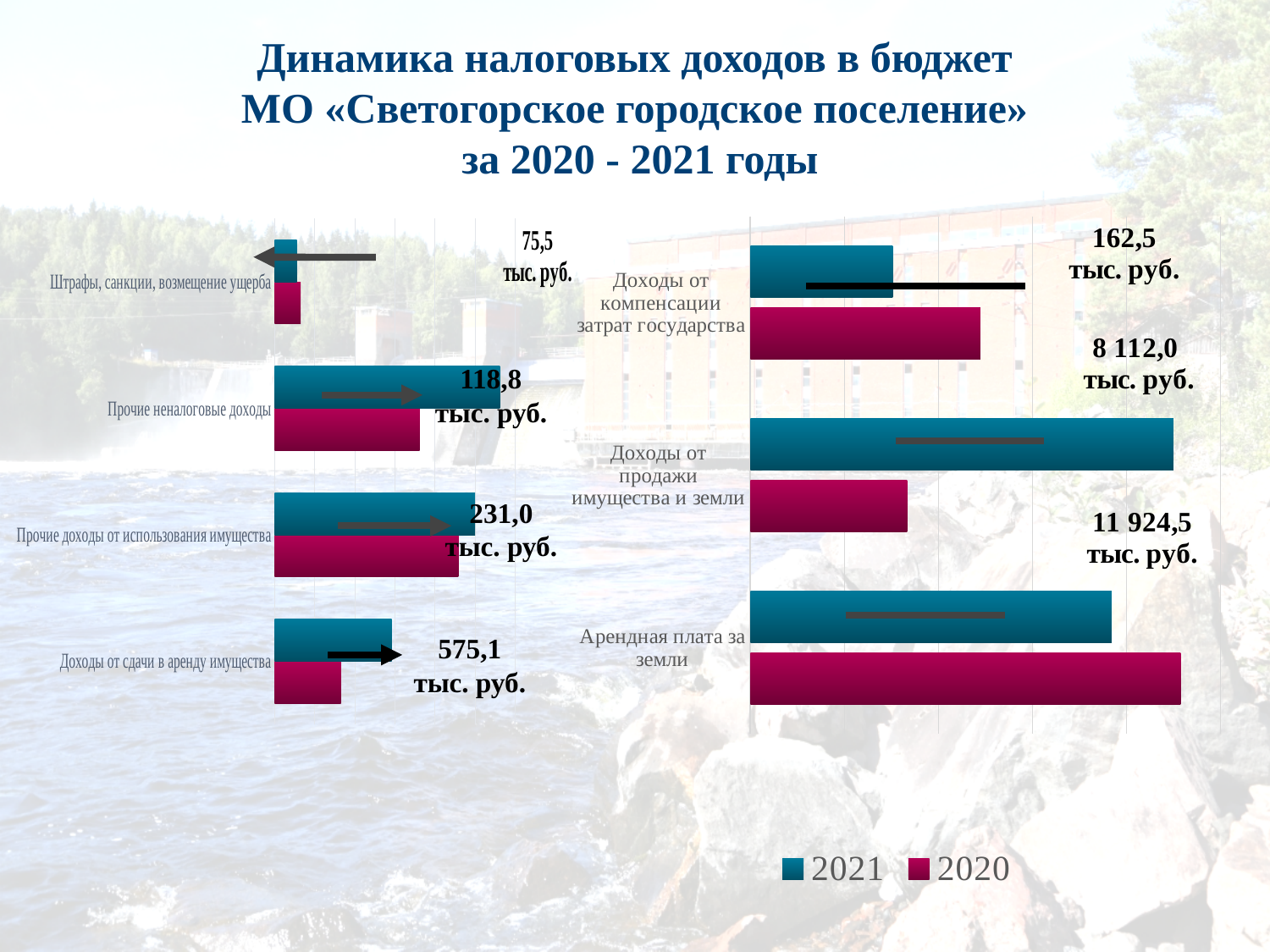
What kind of chart is used on the left side of the slide? bar chart How many series does the legend list? 2 How many categories are shown in the right chart? 3 In the right chart, which category has the shortest 2020 bar? Доходы от продажи имущества и земли In the right chart, which category has the longest 2020 bar? Арендная плата за земли How many categories are shown in the left chart? 4 In the right chart, for Доходы от компенсации затрат государства, which year has the larger bar, 2021 or 2020? 2020 In the right chart, for Доходы от продажи имущества и земли, which year has the larger bar, 2021 or 2020? 2021 In the left chart, for Штрафы, санкции, возмещение ущерба, which year has the larger bar, 2021 or 2020? 2020 In the right chart, which category has the longest 2021 bar? Доходы от продажи имущества и земли Which two years are listed in the legend? 2021 and 2020